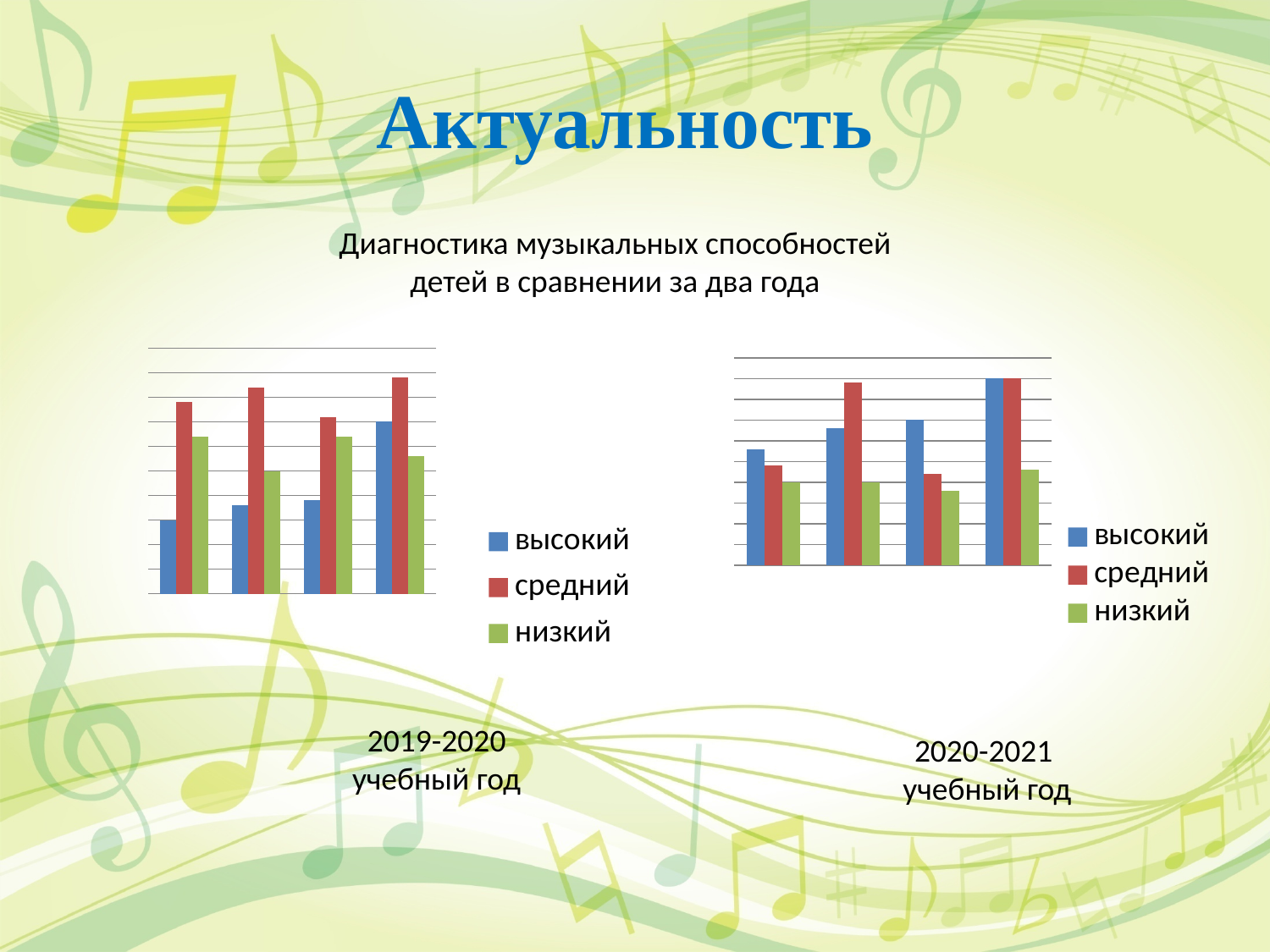
What kind of chart is the 2020-2021 учебный год chart? bar chart What colour represents the низкий series in the legend of the 2020-2021 учебный год chart? green In the 2019-2020 учебный год chart, does the высокий series rise or fall from the first group to the fourth group? rise In the 2019-2020 учебный год chart, which series has the tallest bar in the first group? средний How many groups of bars are plotted in the 2020-2021 учебный год chart? 4 In the 2020-2021 учебный год chart, which is larger in the third group: высокий or средний? высокий In the 2019-2020 учебный год chart, which series has the shortest bar in the first group? высокий What kind of chart is the 2019-2020 учебный год chart? bar chart How many series does the legend of the 2019-2020 учебный год chart list? 3 In the 2020-2021 учебный год chart, which series has the shortest bar in the fourth group? низкий How many groups of bars are plotted in the 2019-2020 учебный год chart? 4 How many series does the legend of the 2020-2021 учебный год chart list? 3